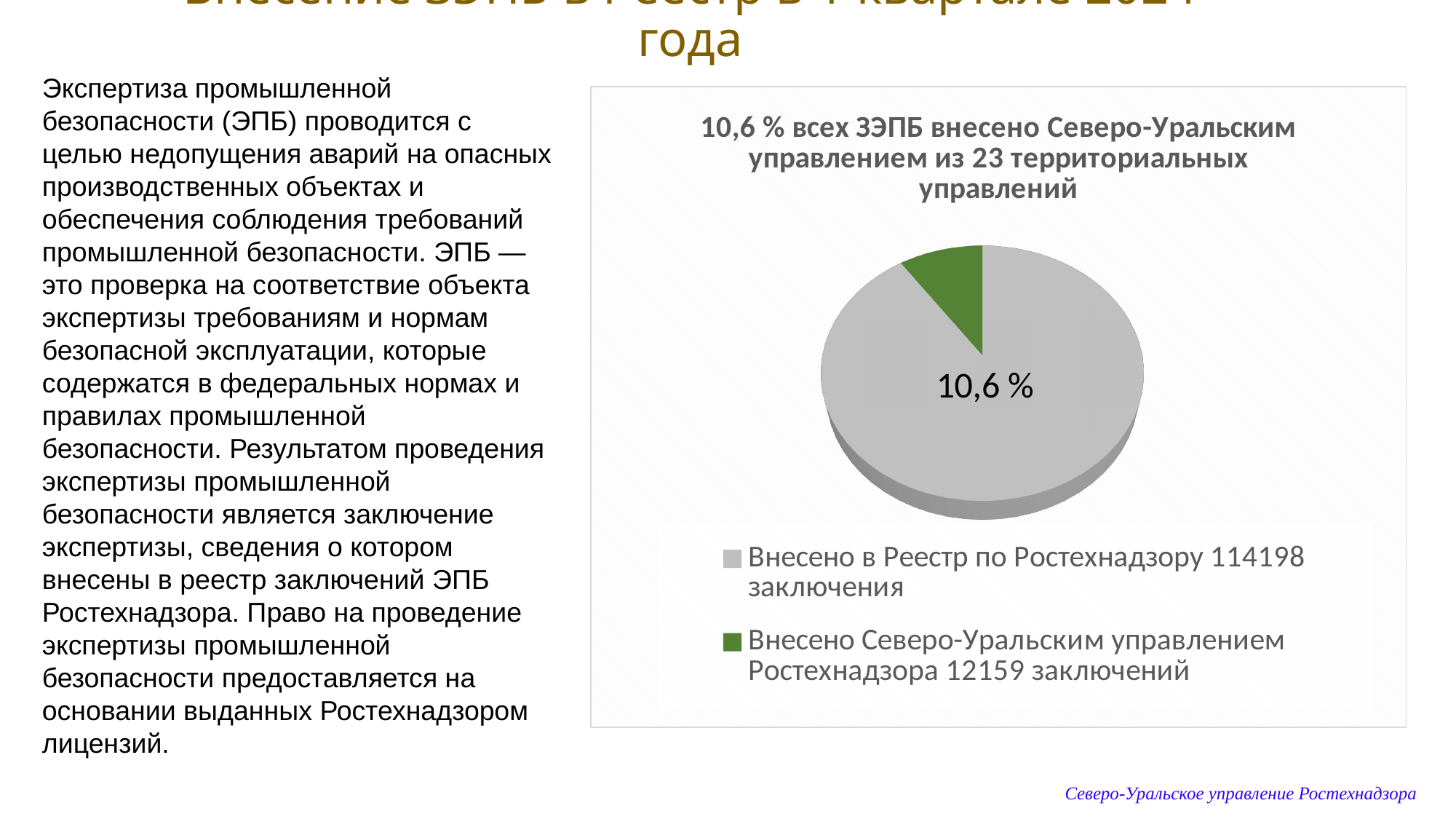
How many заключения are given in the legend for 'Внесено в Реестр по Ростехнадзору'? 114198 How many заключений are given in the legend for 'Внесено Северо-Уральским управлением Ростехнадзора'? 12159 Which slice of the pie chart is the largest? Внесено в Реестр по Ростехнадзору What kind of chart is shown on the slide? pie chart What share of the pie is labelled for the slice 'Внесено Северо-Уральским управлением Ростехнадзора'? 10,6 % How many entries does the legend of the pie chart list? 2 Which is larger: the number for 'Внесено в Реестр по Ростехнадзору' or for 'Внесено Северо-Уральским управлением Ростехнадзора'? Внесено в Реестр по Ростехнадзору What colour is the slice for 'Внесено Северо-Уральским управлением Ростехнадзора'? green According to the chart title, out of how many территориальных управлений did the Северо-Уральское управление contribute 10,6 % of all ЗЭПБ? 23 Which slice of the pie chart is the smallest? Внесено Северо-Уральским управлением Ростехнадзора What is the difference between the 114198 заключения for 'Внесено в Реестр по Ростехнадзору' and the 12159 заключений for 'Внесено Северо-Уральским управлением Ростехнадзора'? 102039 How many slices does the pie chart have? 2